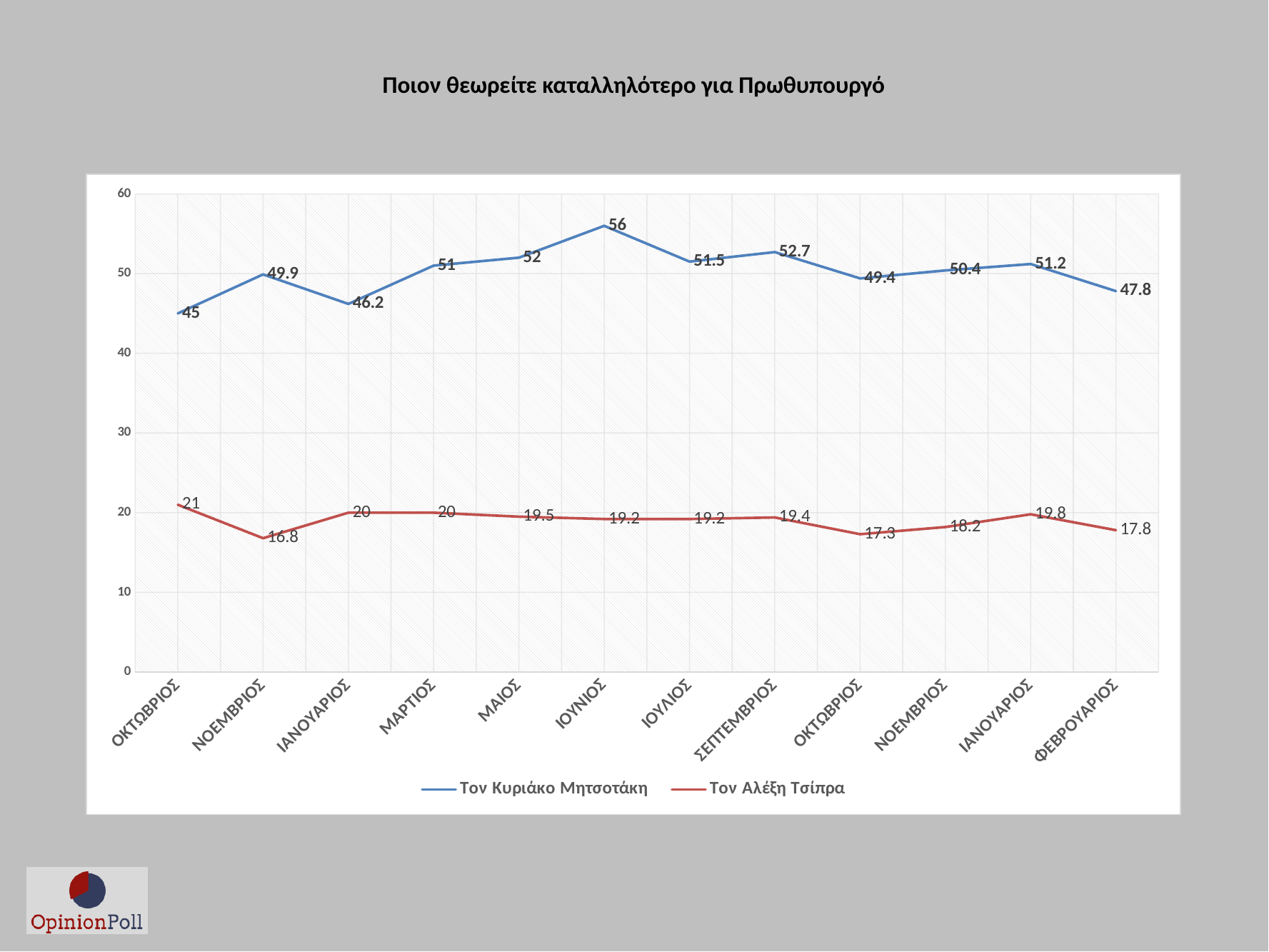
What is the value for Τον Αλέξη Τσίπρα in ΦΕΒΡΟΥΑΡΙΟΣ? 17.8 Which series has the higher value in ΦΕΒΡΟΥΑΡΙΟΣ? Τον Κυριάκο Μητσοτάκη How many series does the legend list? 2 What is the value for Τον Κυριάκο Μητσοτάκη in ΜΑΡΤΙΟΣ? 51 What type of chart is shown on the slide? line chart What is the title of the chart? Ποιον θεωρείτε καταλληλότερο για Πρωθυπουργό In which month does Τον Κυριάκο Μητσοτάκη reach its highest value? ΙΟΥΝΙΟΣ Is the value for Τον Αλέξη Τσίπρα in ΜΑΙΟΣ greater or less than 30? less In which month does Τον Αλέξη Τσίπρα have its lowest value? ΝΟΕΜΒΡΙΟΣ (the first one) What is the value for Τον Κυριάκο Μητσοτάκη in ΙΟΥΝΙΟΣ? 56 What is the difference between the two series in ΙΟΥΝΙΟΣ? 36.8 How many data points does each line have? 12